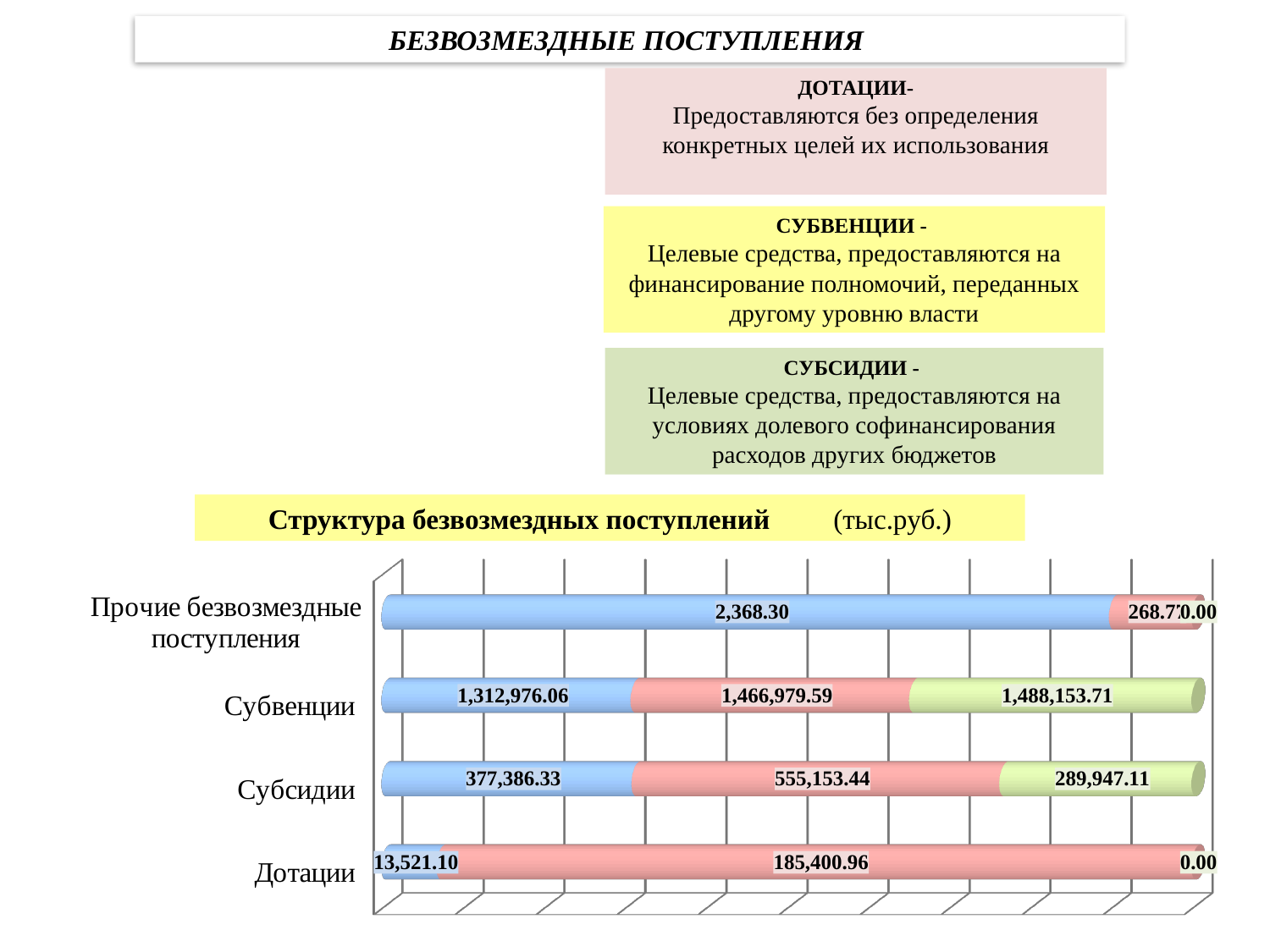
What is the total of the three labelled values on the 'Субсидии' bar? 1,222,486.88 Which is larger: the red segment of 'Субвенции' or the red segment of 'Субсидии'? Субвенции What is the difference between the red segment (555,153.44) and the blue segment (377,386.33) of the 'Субсидии' bar? 177,767.11 What is the value of the blue (first) segment of the 'Прочие безвозмездные поступления' bar? 2,368.30 What type of chart is shown under the title 'Структура безвозмездных поступлений'? Stacked bar chart What is the value of the green (third) segment of the 'Субвенции' bar? 1,488,153.71 What is the value of the blue (first) segment of the 'Дотации' bar? 13,521.10 What is the value of the red (middle) segment of the 'Субсидии' bar? 555,153.44 What is the smallest value labelled on the 'Субсидии' bar? 289,947.11 How many categories are shown on the vertical axis of the chart? 4 What is the largest value labelled on the 'Субвенции' bar? 1,488,153.71 What is the value of the red (middle) segment of the 'Дотации' bar? 185,400.96